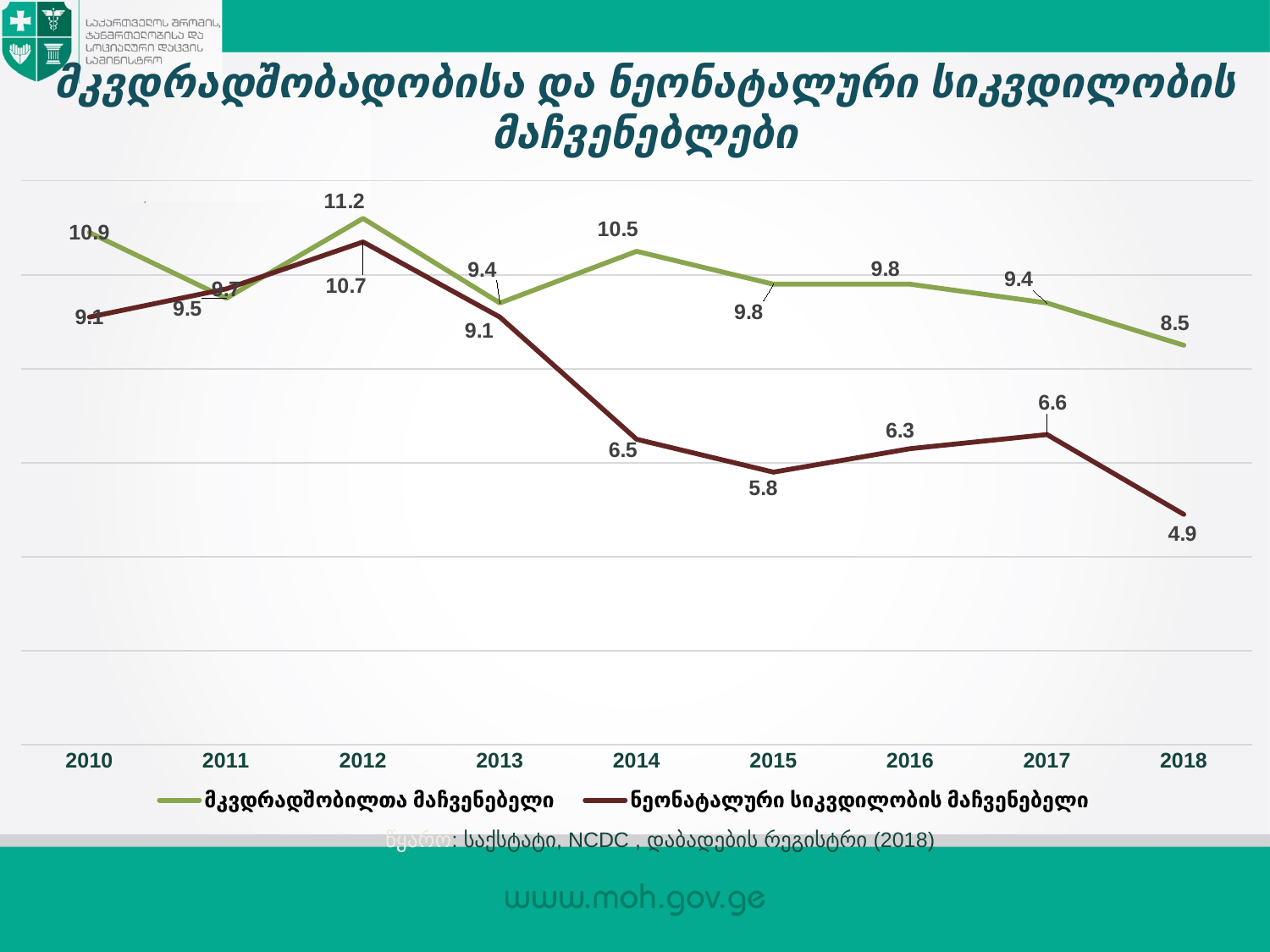
Which series has the higher value in 2017? მკვდრადშობილთა მაჩვენებელი In which year is ნეონატალური სიკვდილობის მაჩვენებელი lowest? 2018 How many years are shown on the x axis? 9 What is the difference between მკვდრადშობილთა მაჩვენებელი and ნეონატალური სიკვდილობის მაჩვენებელი in 2014? 4 How many series does the legend list? 2 In which year is მკვდრადშობილთა მაჩვენებელი highest? 2012 What is the value of ნეონატალური სიკვდილობის მაჩვენებელი in 2015? 5.8 What colour is the line for ნეონატალური სიკვდილობის მაჩვენებელი? dark red What type of chart is shown on the slide? line chart What is the value of მკვდრადშობილთა მაჩვენებელი in 2012? 11.2 Does ნეონატალური სიკვდილობის მაჩვენებელი rise or fall from 2013 to 2015? fall What is the value of ნეონატალური სიკვდილობის მაჩვენებელი in 2018? 4.9